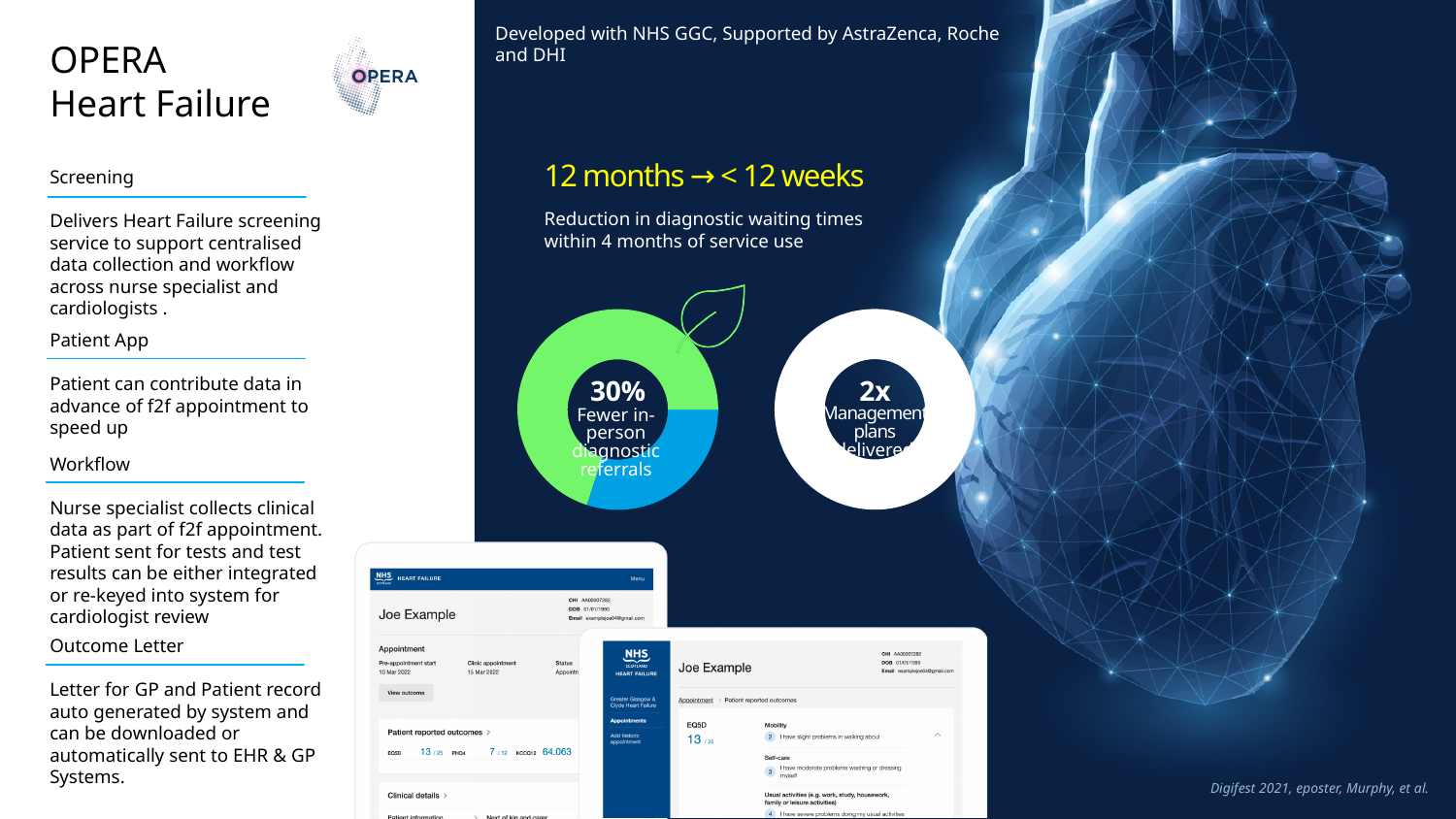
Does the blue segment of the doughnut chart cover more or less than half of the ring? less How many segments does the doughnut chart have? 2 What percentage is printed in the centre of the doughnut chart? 30% In the doughnut chart, which segment is larger, the green one or the blue one? green What does the 30% in the centre of the doughnut chart refer to? Fewer in-person diagnostic referrals What colour is the larger segment of the doughnut chart? green What kind of chart is shown in the middle of the slide, below the '12 months → < 12 weeks' heading? doughnut chart